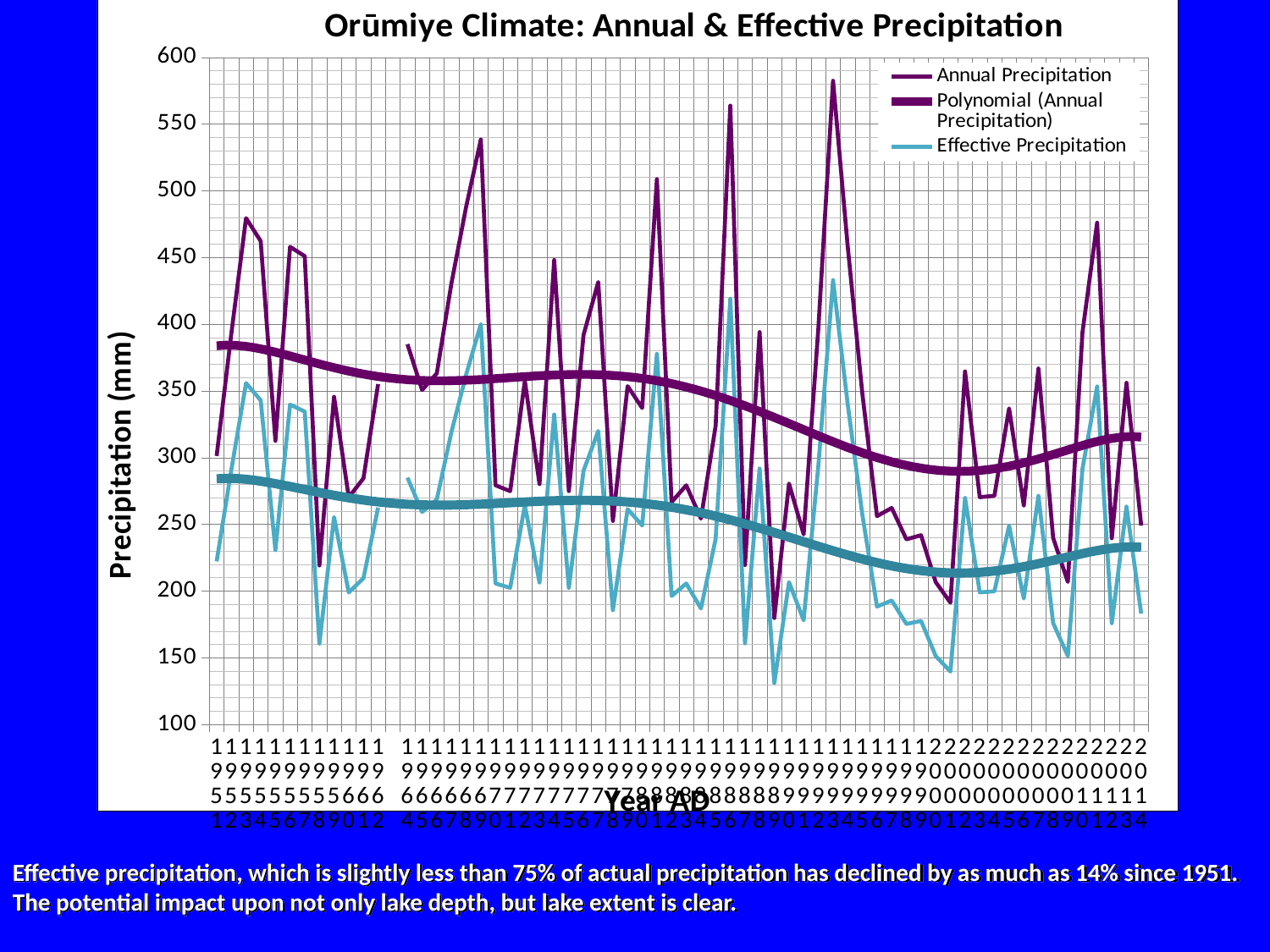
What is the maximum value shown on the vertical axis? 600 Is the lowest value of the Effective Precipitation series greater or less than 150? less Is the highest value of the Effective Precipitation series greater or less than 400? greater Which series is generally higher, Annual Precipitation or Effective Precipitation? Annual Precipitation What is the label of the vertical axis? Precipitation (mm) Is the Polynomial (Annual Precipitation) line at the left edge of the chart greater or less than 350? greater What kind of chart is shown on the slide? Line chart What is the title of the chart? Orūmiye Climate: Annual & Effective Precipitation How many series does the legend list? 3 Does the Polynomial (Annual Precipitation) trend line overall rise or fall from the left of the chart to the right? fall